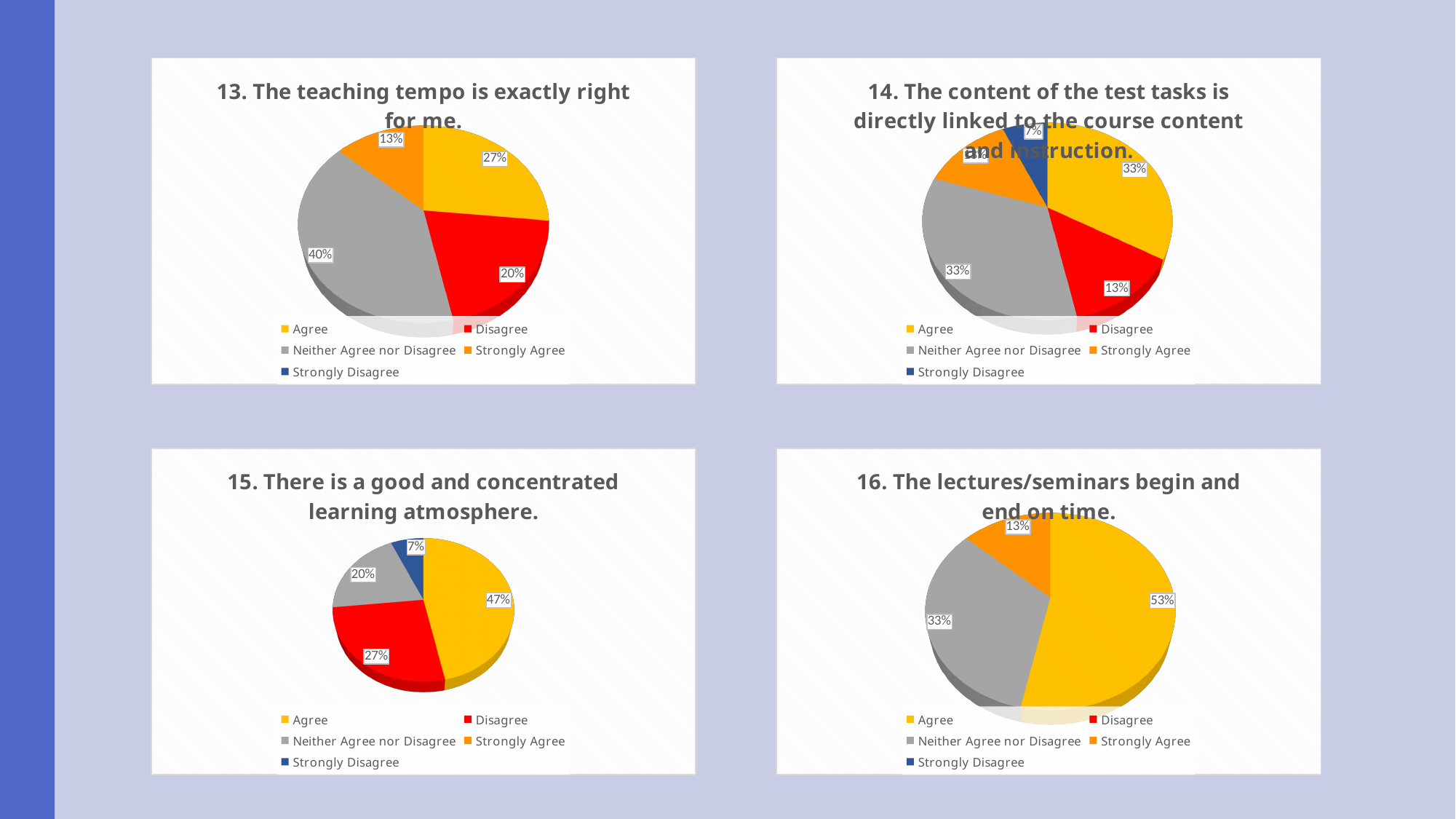
In the chart titled "14. The content of the test tasks is directly linked to the course content and instruction.", what percentage is shown for Strongly Disagree? 7% In the chart titled "13. The teaching tempo is exactly right for me.", what percentage is shown for Neither Agree nor Disagree? 40% In the chart titled "15. There is a good and concentrated learning atmosphere.", which is larger, Disagree or Neither Agree nor Disagree? Disagree In the chart titled "15. There is a good and concentrated learning atmosphere.", what percentage is shown for Agree? 47% In the chart titled "16. The lectures/seminars begin and end on time.", what is the difference between the Agree and Neither Agree nor Disagree shares? 20% In the chart titled "14. The content of the test tasks is directly linked to the course content and instruction.", what percentage is shown for Disagree? 13% In the chart titled "13. The teaching tempo is exactly right for me.", what is the difference between the Agree and Disagree shares? 7% In the chart titled "13. The teaching tempo is exactly right for me.", which response has the largest share? Neither Agree nor Disagree What kind of chart is used in the chart titled "16. The lectures/seminars begin and end on time."? Pie chart How many entries does the legend list in the chart titled "13. The teaching tempo is exactly right for me."? 5 In the chart titled "15. There is a good and concentrated learning atmosphere.", which response has the smallest share? Strongly Disagree In the chart titled "16. The lectures/seminars begin and end on time.", what percentage is shown for Agree? 53%